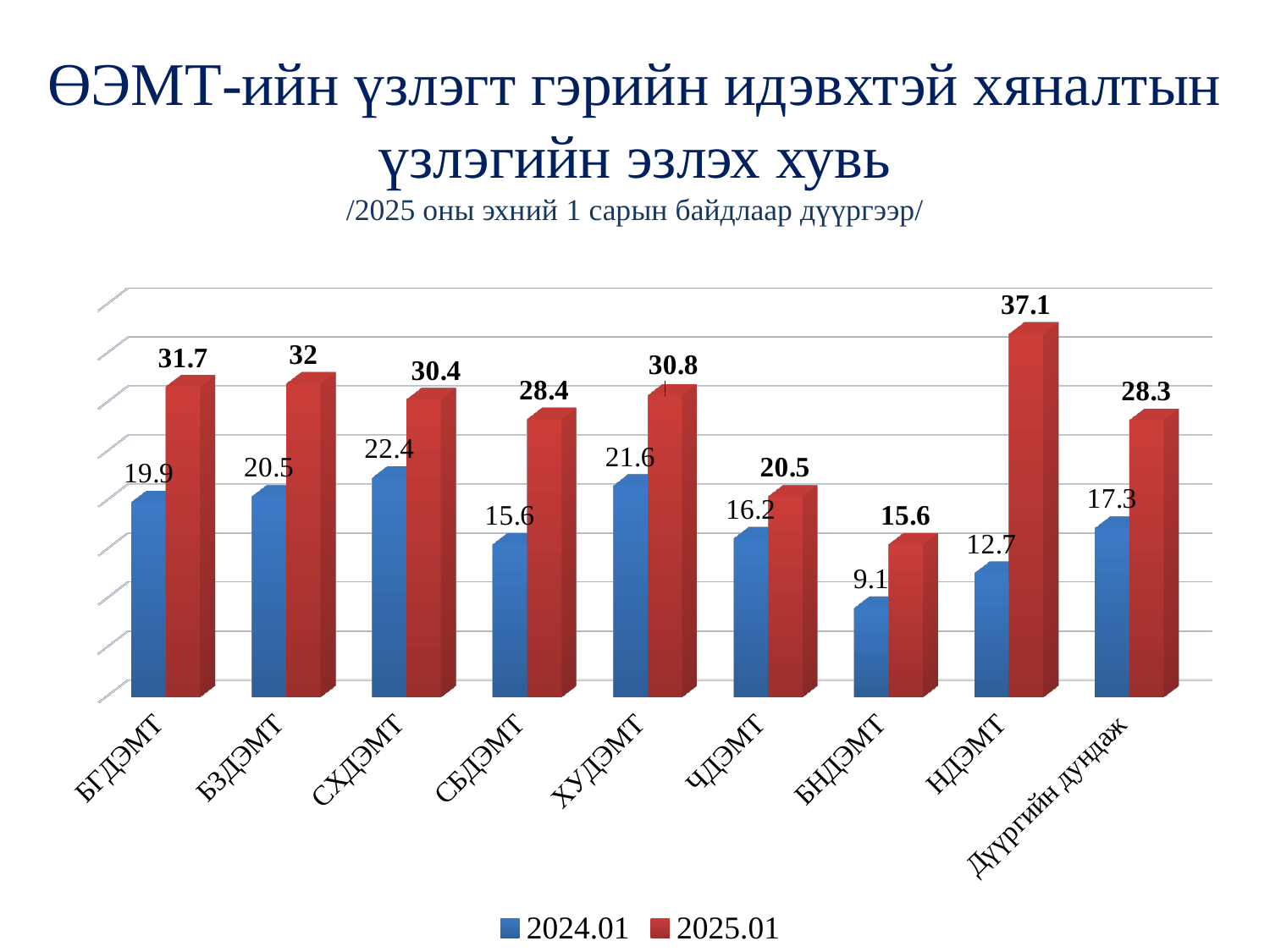
Which category has the lowest value in the 2024.01 series? БНДЭМТ What is the difference between the 2025.01 and 2024.01 values for НДЭМТ? 24.4 What is the difference between the 2025.01 and 2024.01 values for СХДЭМТ? 8 What is the value for Дүүргийн дундаж in the 2025.01 series? 28.3 What is the value for НДЭМТ in the 2025.01 series? 37.1 What kind of chart is shown on the slide? Bar chart What is the value for БНДЭМТ in the 2024.01 series? 9.1 Which category has the highest value in the 2025.01 series? НДЭМТ Which is larger for ЧДЭМТ: the 2024.01 value or the 2025.01 value? 2025.01 Which category has the lowest value in the 2025.01 series? БНДЭМТ How many categories are shown on the x axis? 9 How many series does the legend list? 2